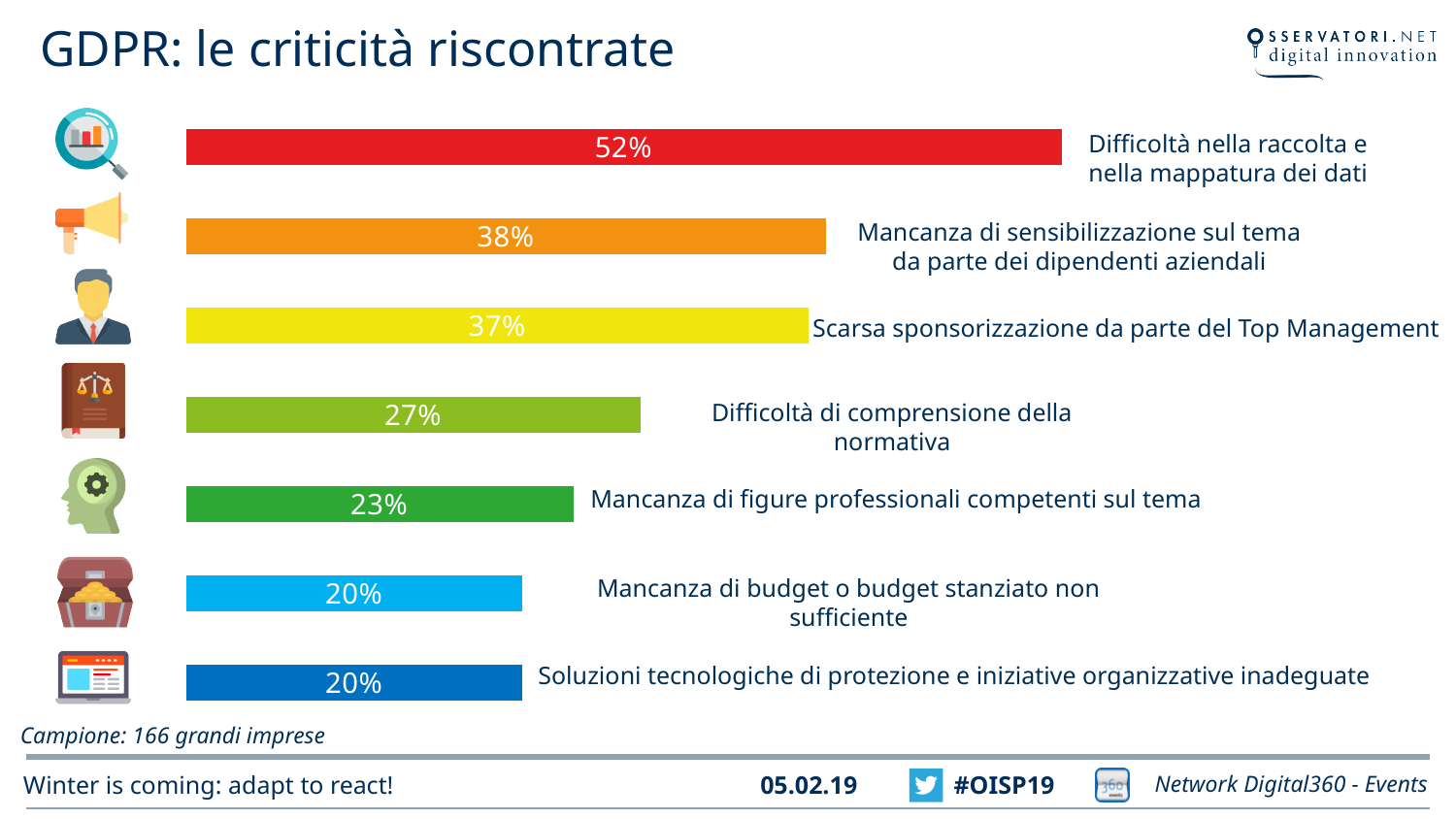
What is the difference in percentage points between "Mancanza di sensibilizzazione sul tema da parte dei dipendenti aziendali" and "Scarsa sponsorizzazione da parte del Top Management"? 1 What kind of chart is shown on the slide? Bar chart What is the sample size stated below the chart? 166 grandi imprese What percentage is shown for "Mancanza di figure professionali competenti sul tema"? 23% What is the difference in percentage points between "Difficoltà nella raccolta e nella mappatura dei dati" and "Mancanza di sensibilizzazione sul tema da parte dei dipendenti aziendali"? 14 Which criticality has the highest percentage? Difficoltà nella raccolta e nella mappatura dei dati What percentage is shown for "Scarsa sponsorizzazione da parte del Top Management"? 37% How many bars share the lowest value of 20%? 2 What is the title of the slide? GDPR: le criticità riscontrate Which is larger: the value for "Difficoltà di comprensione della normativa" or the value for "Mancanza di budget o budget stanziato non sufficiente"? Difficoltà di comprensione della normativa How many criticalities (bars) are shown on the chart? 7 What percentage is shown for "Difficoltà nella raccolta e nella mappatura dei dati"? 52%